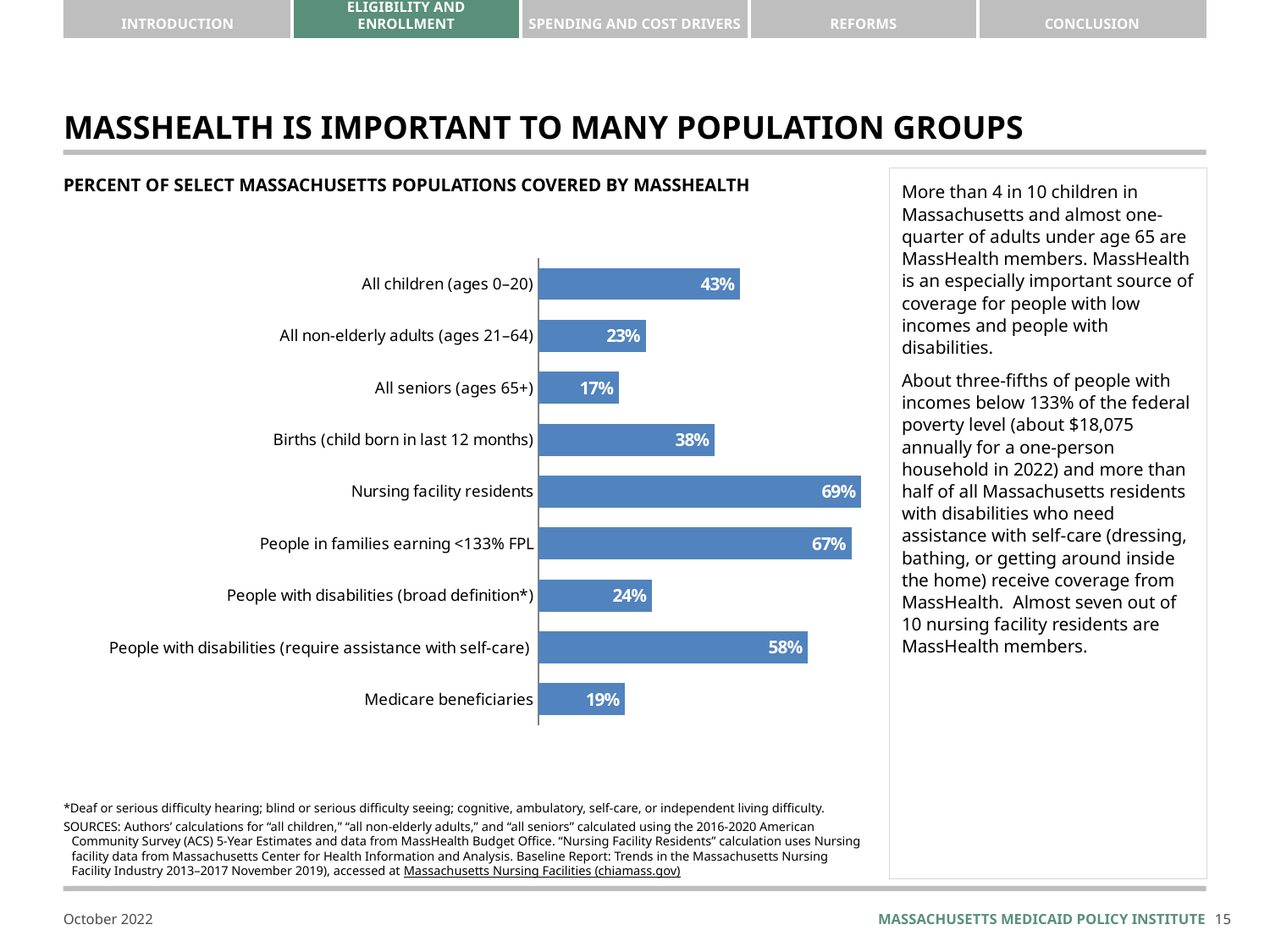
Which is larger: the percent for births (child born in last 12 months) or the percent for people with disabilities (broad definition*)? Births (child born in last 12 months) What percent of nursing facility residents are covered by MassHealth? 69% What is the difference in percentage points between nursing facility residents and people in families earning <133% FPL? 2 What is the title of the chart? Percent of select Massachusetts populations covered by MassHealth What percent of all children (ages 0–20) are covered by MassHealth? 43% Which population group has the highest percent covered by MassHealth? Nursing facility residents What percent of people with disabilities (require assistance with self-care) are covered by MassHealth? 58% What percent of Medicare beneficiaries are covered by MassHealth? 19% How many population groups are shown in the chart? 9 What is the difference in percentage points between all children (ages 0–20) and all non-elderly adults (ages 21–64)? 20 What kind of chart is shown on the slide? Bar chart Which population group has the lowest percent covered by MassHealth? All seniors (ages 65+)